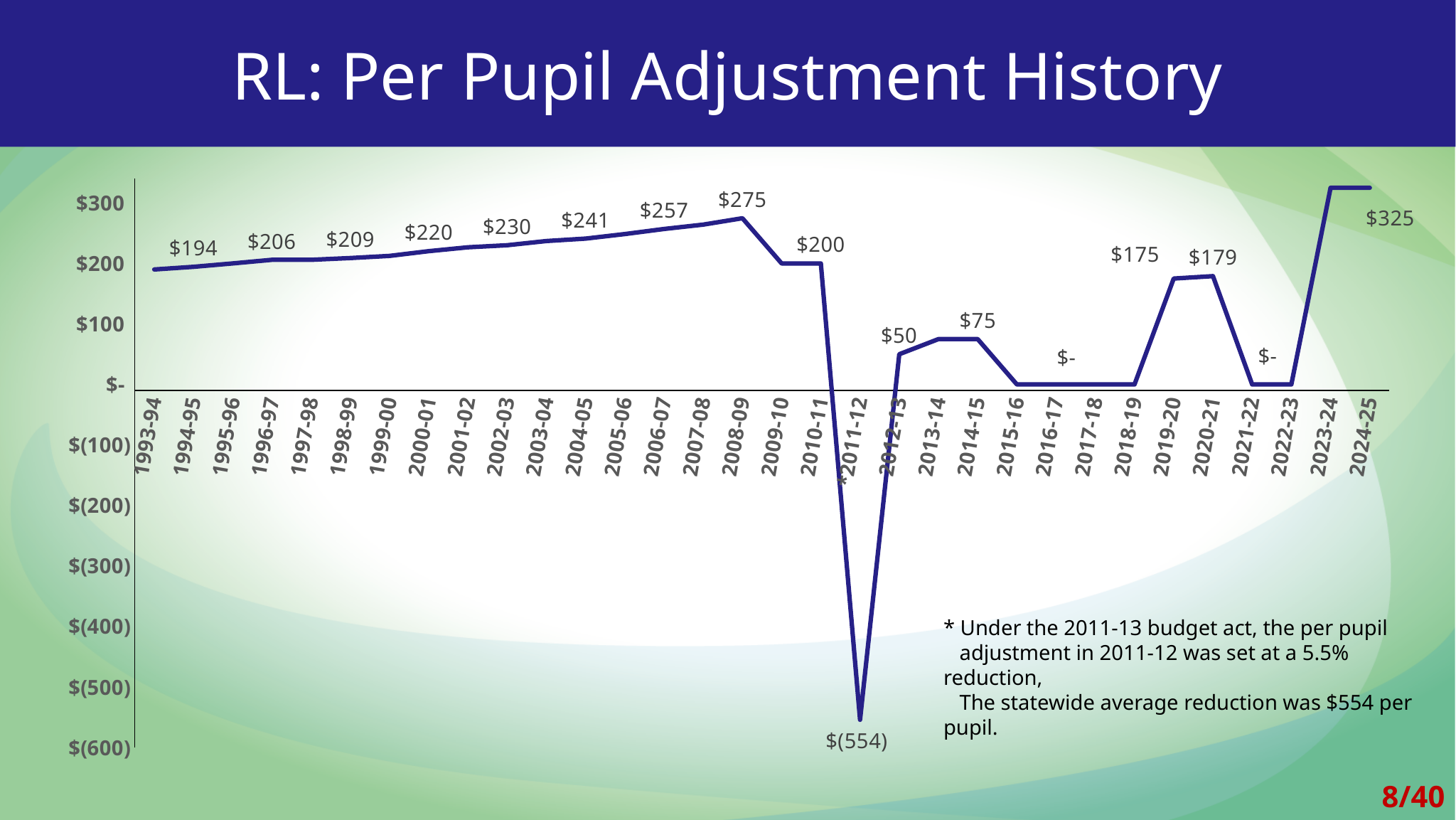
What is the title of the chart? RL: Per Pupil Adjustment History What is the per pupil adjustment for 2024-25? $325 What is the per pupil adjustment for 2008-09? $275 Does the per pupil adjustment rise or fall from 1993-94 to 2008-09? rise What is the per pupil adjustment for 2020-21? $179 What kind of chart is shown on the slide? line chart Which year has the highest per pupil adjustment? 2023-24 and 2024-25 (tied at $325) What is the difference between the 2024-25 value ($325) and the 2008-09 value ($275)? $50 Which is larger, the per pupil adjustment for 2019-20 or for 2020-21? 2020-21 What is the per pupil adjustment for 2011-12? $(554) Which year has the lowest per pupil adjustment? 2011-12 What is the per pupil adjustment for 2012-13? $50